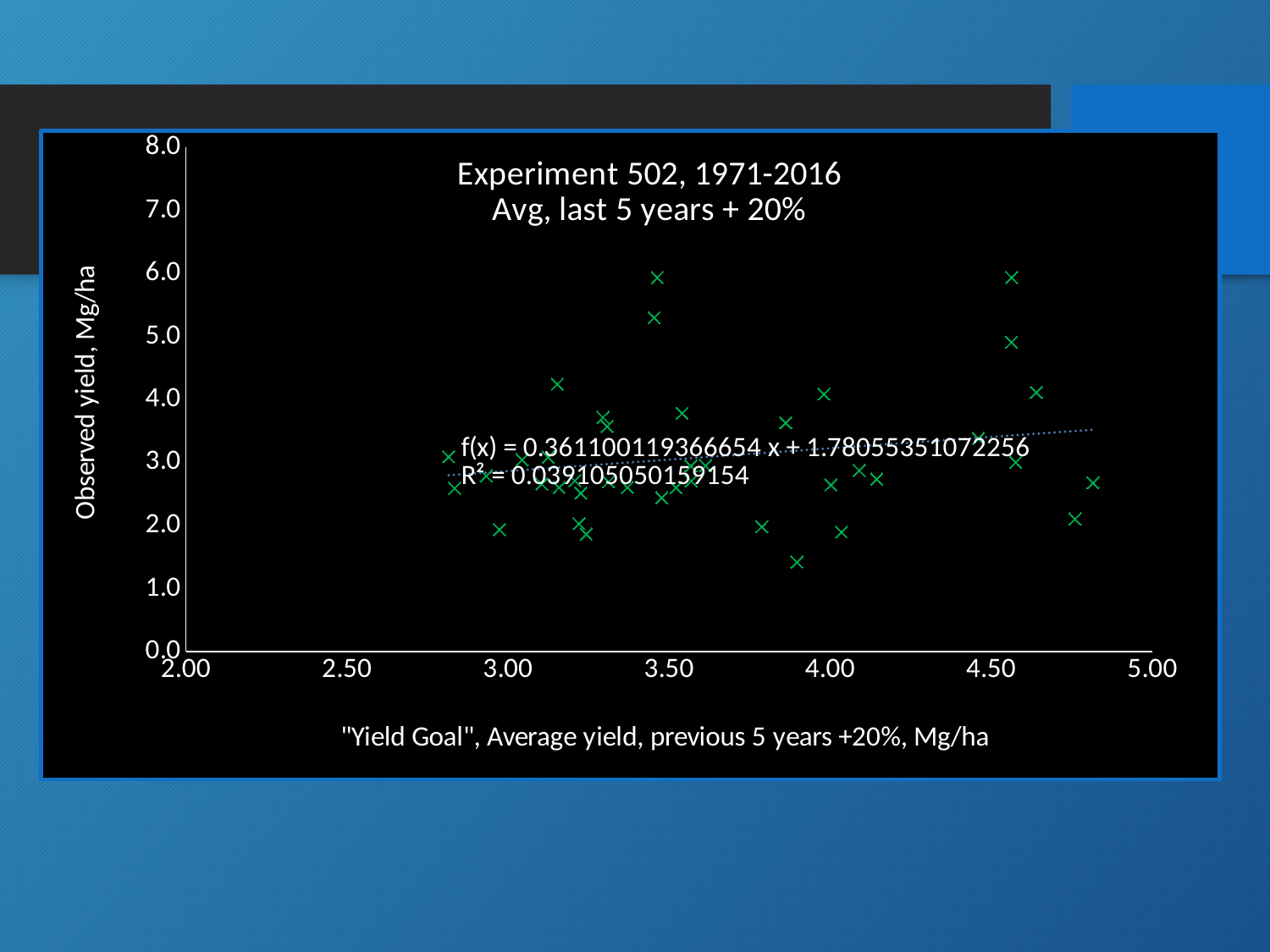
What is the title of the chart? Experiment 502, 1971-2016 Avg, last 5 years + 20% What is the R² value shown for the trendline on the chart? 0.039105050159154 What is the maximum value shown on the y axis? 8.0 What is the label of the vertical axis? Observed yield, Mg/ha Is the highest observed yield plotted on the chart greater or less than 5.0 Mg/ha? greater What is the maximum value shown on the x axis? 5.00 Is the lowest observed yield plotted on the chart greater or less than 2.0 Mg/ha? less What is the trendline equation shown on the chart? f(x) = 0.361100119366654 x + 1.78055351072256 What kind of chart is shown on the slide? scatter chart Does the fitted trendline rise or fall as the yield goal increases along the x axis? rise